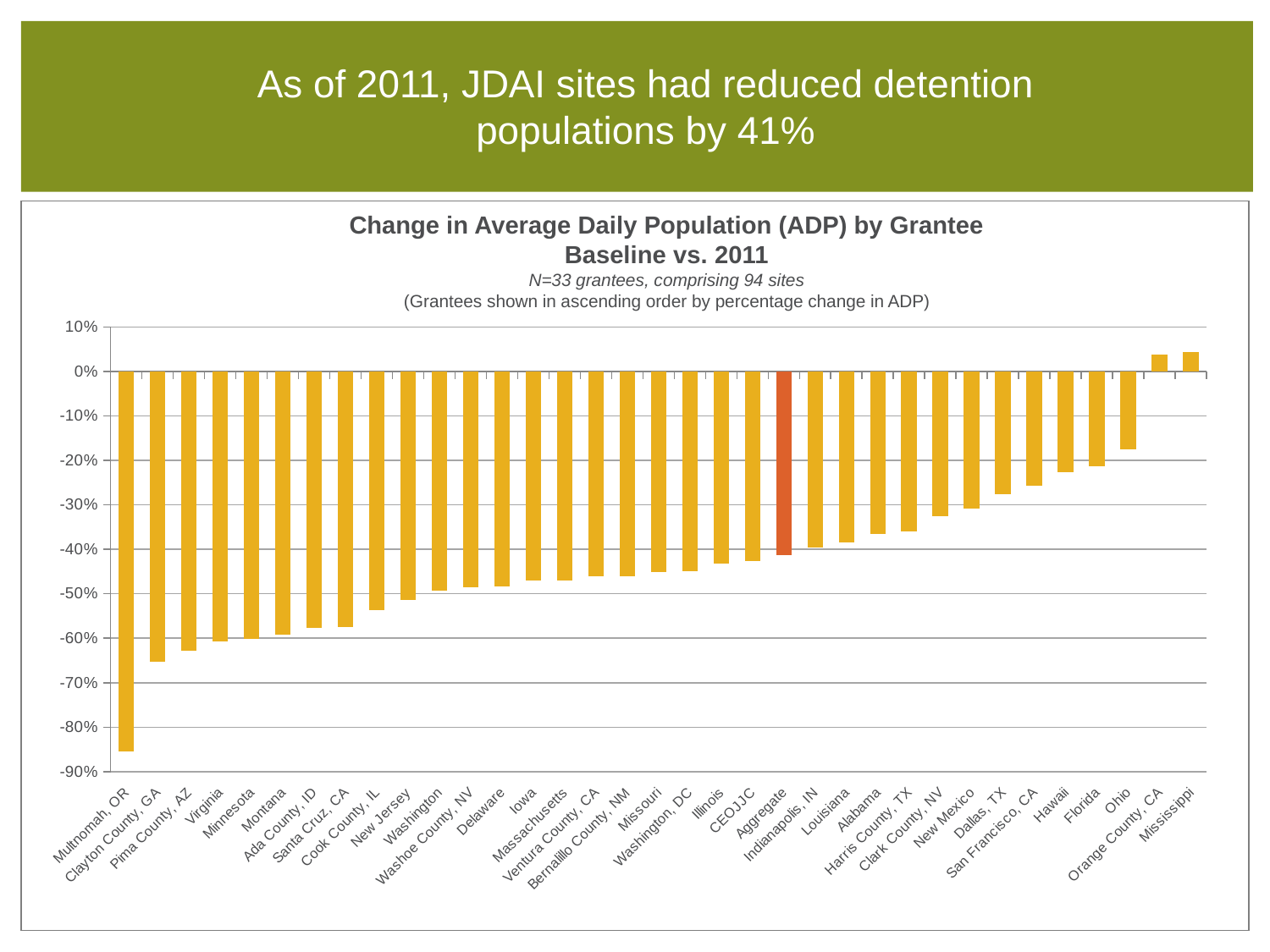
Is the value for Clayton County, GA greater or less than -60%? less Which is larger, the value for Virginia or the value for Ohio? Ohio Is the value for Ohio greater or less than -20%? greater Is the value for Aggregate greater or less than -30%? less Which grantee has the lowest (most negative) change in ADP? Multnomah, OR Do the values rise or fall moving from left to right along the x axis? rise Which bar is shown in a different colour (orange-red) from the others? Aggregate According to the chart subtitle, how many grantees are included? 33 What kind of chart is shown on the slide? bar chart